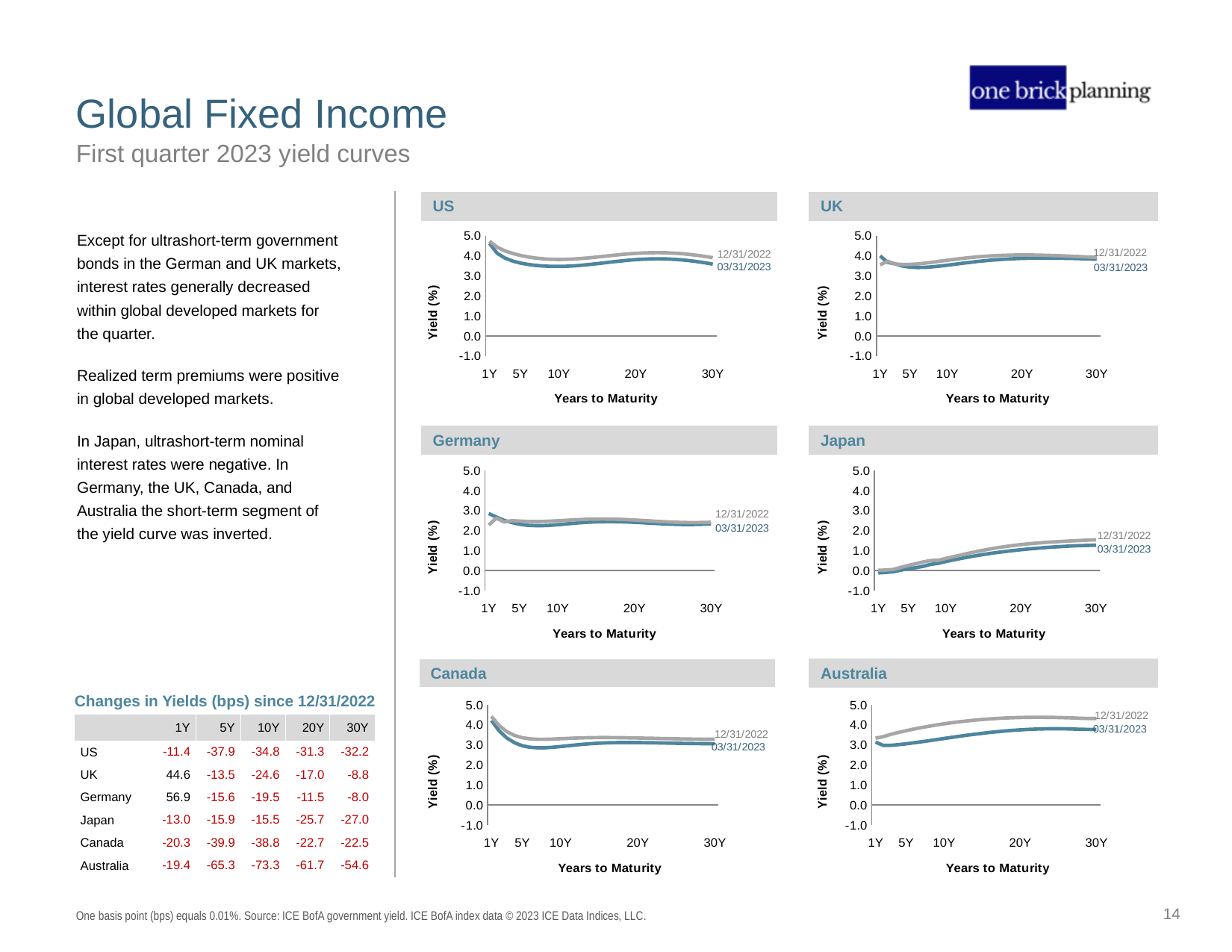
In the US chart, does the 03/31/2023 line rise or fall from 1Y to 10Y? fall In the UK chart, is the 03/31/2023 value at 30Y greater or less than 3.0? greater In the Japan chart, is the 03/31/2023 value at 30Y greater or less than 2.0? less In the US chart, is the 03/31/2023 value at 1Y greater or less than 4.0? greater How many maturity tick labels are shown on the x axis of the Canada chart? 5 What kind of chart is the US chart? line chart What is the x-axis title of the Australia chart? Years to Maturity In the Germany chart, which series is higher at 1Y, 12/31/2022 or 03/31/2023? 03/31/2023 In the Japan chart, does the 03/31/2023 line rise or fall from 1Y to 30Y? rise In the Australia chart, which series is higher at 20Y, 12/31/2022 or 03/31/2023? 12/31/2022